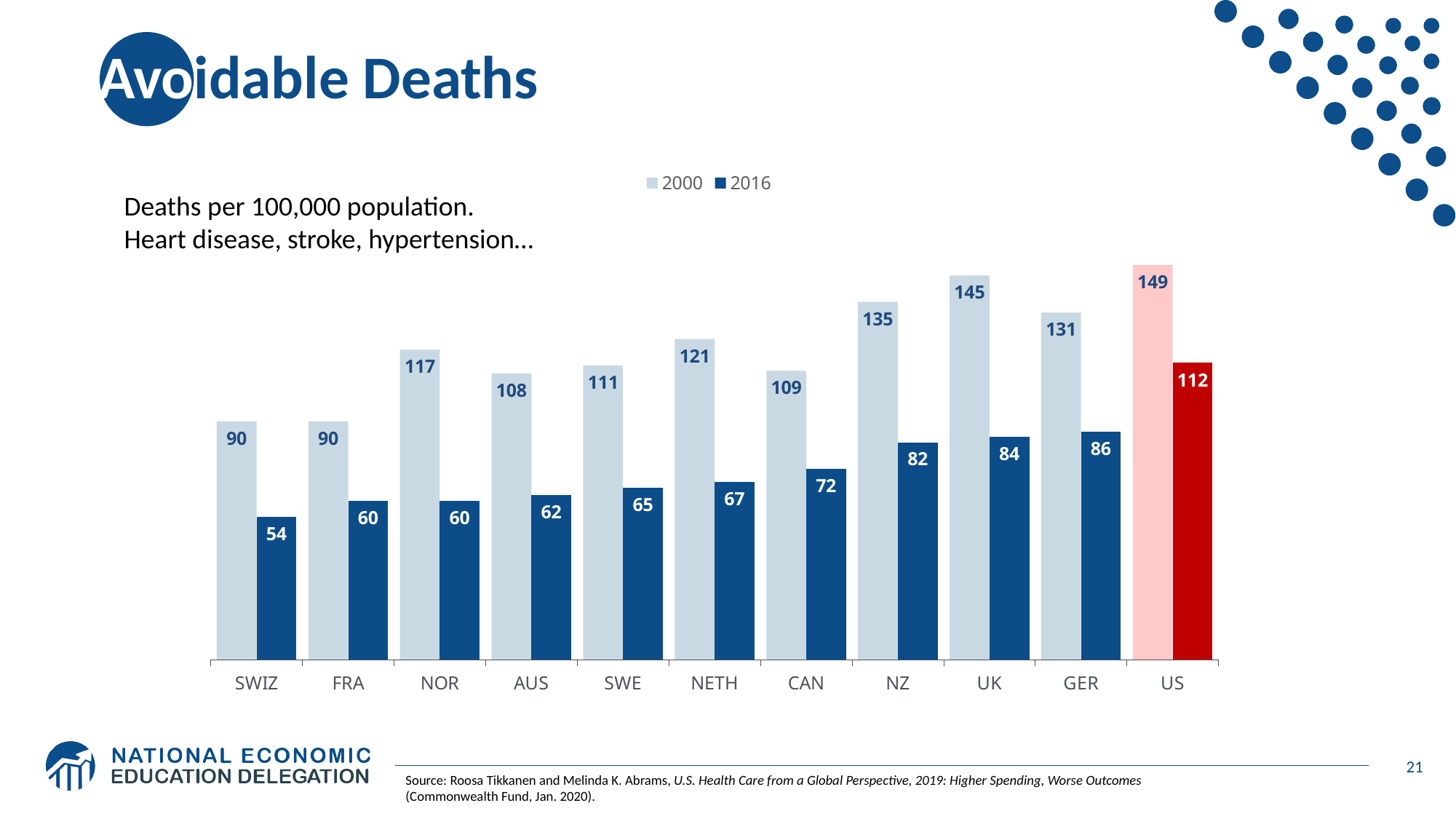
How many series does the legend list? 2 How many countries are shown on the x axis? 11 Which two countries share the same 2000 value of 90? SWIZ and FRA What kind of chart is shown on the slide? Bar chart What is the difference between the US values for 2000 and 2016? 37 What was the value for the UK in 2000? 145 Which country had the lowest value in 2016? SWIZ Which country's bars are coloured red instead of blue? US What was the value for the US in 2000? 149 What was the value for Switzerland (SWIZ) in 2016? 54 Which is larger, the 2016 value for Germany (GER) or the 2016 value for the UK? GER Which country had the highest value in 2016? US